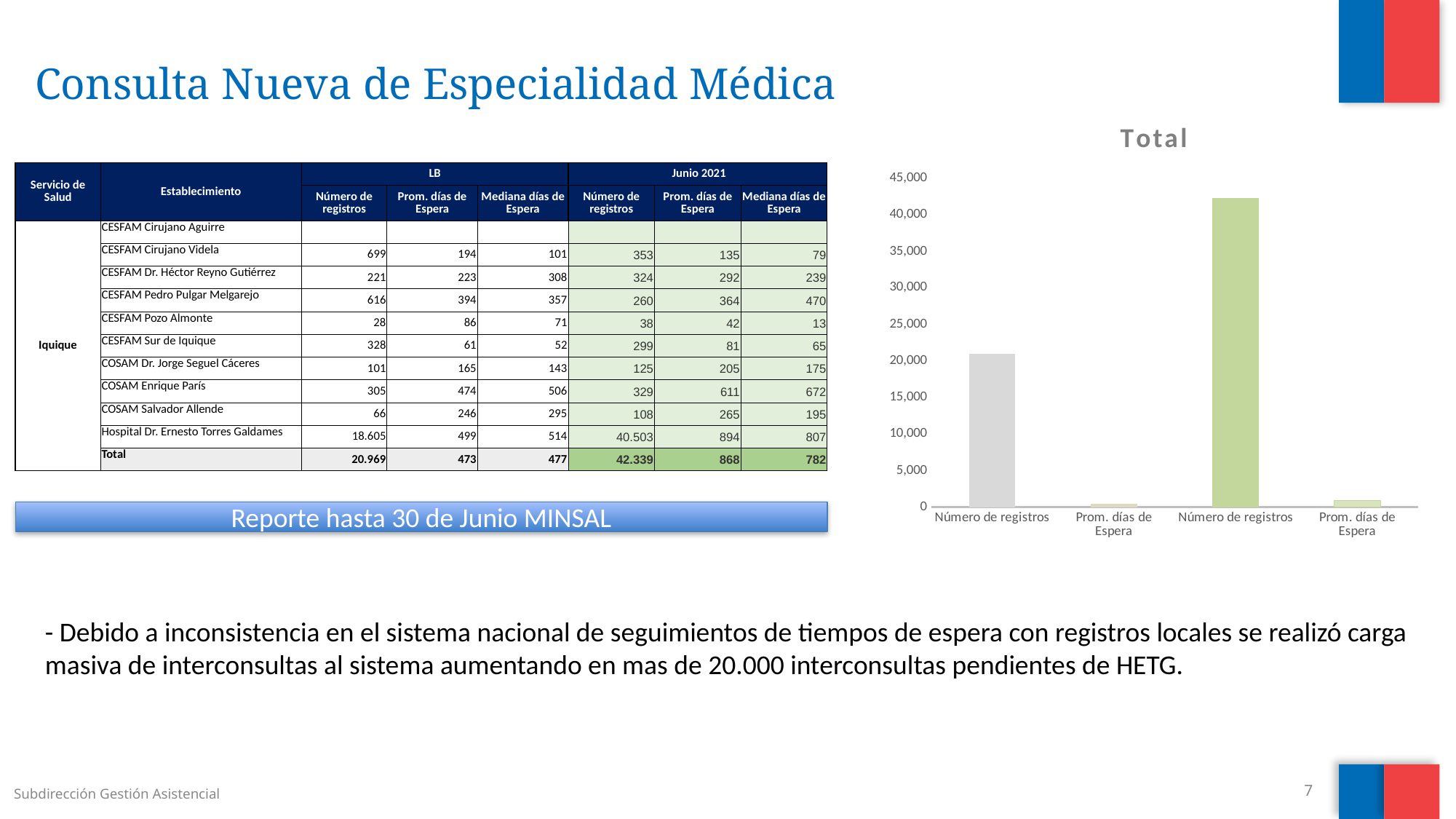
How many bars are plotted in the chart titled "Total"? 4 In the chart titled "Total", which is larger: the first bar from the left (Número de registros) or the third bar from the left (Número de registros)? the third bar In the chart titled "Total", what colour is the tallest bar? green What kind of chart is the chart titled "Total"? bar chart In the chart titled "Total", is the value of the third bar from the left (Número de registros) greater or less than 45,000? less In the chart titled "Total", is the value of the first bar from the left (Número de registros) greater or less than 25,000? less In the chart titled "Total", is the value of the second bar from the left (Prom. días de Espera) greater or less than 5,000? less What is the title of the bar chart on the right side of the slide? Total In the chart titled "Total", which bar is the tallest? the third bar (Número de registros)